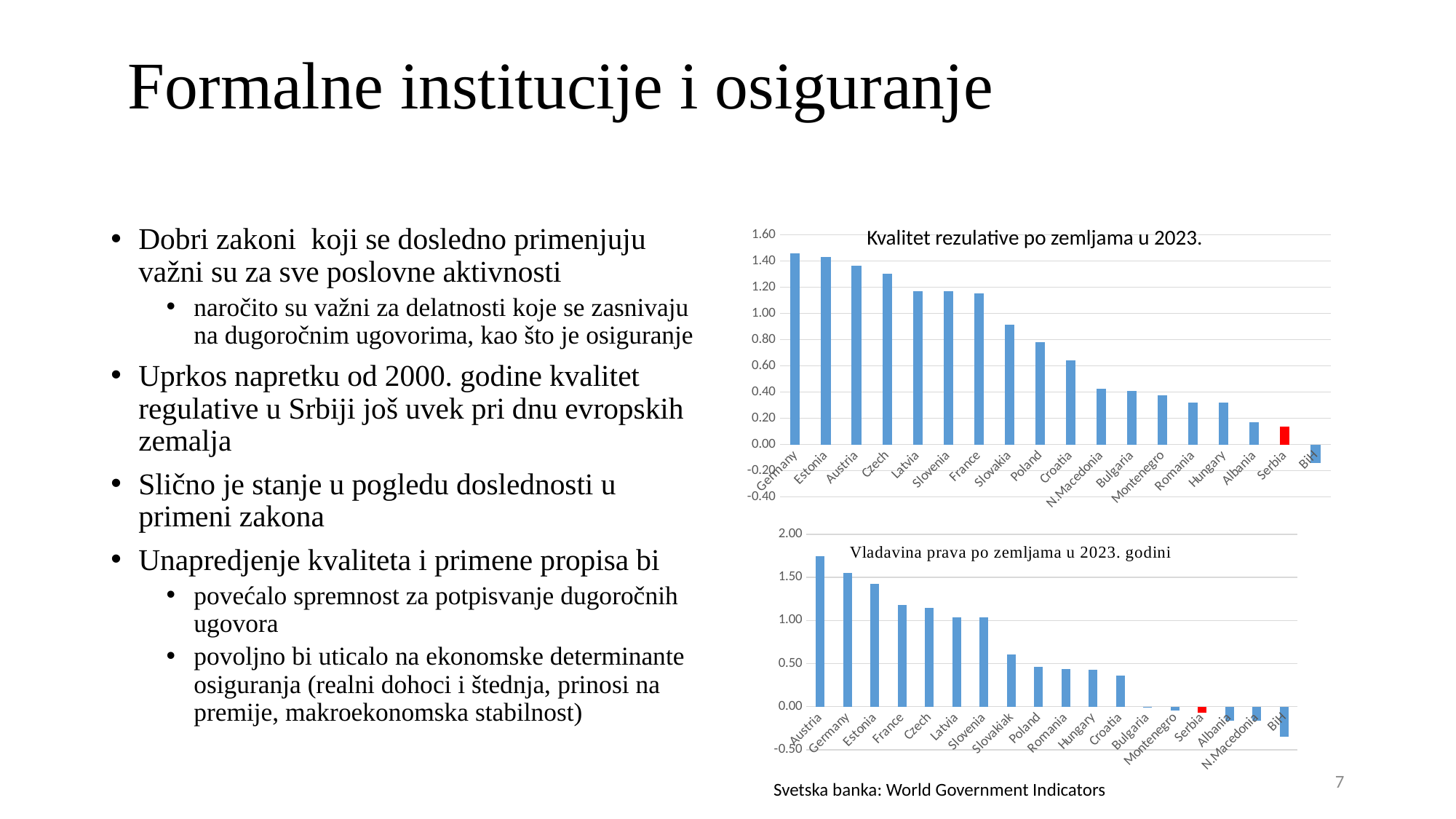
In the top chart, 'Kvalitet rezulative po zemljama u 2023.', which country has the highest value? Germany In the bottom chart, 'Vladavina prava po zemljama u 2023. godini', which country has the lowest value? BiH In the bottom chart, 'Vladavina prava po zemljama u 2023. godini', which has the larger value, Estonia or Croatia? Estonia In the bottom chart, 'Vladavina prava po zemljama u 2023. godini', how many countries are plotted? 18 In the bottom chart, 'Vladavina prava po zemljama u 2023. godini', is the value for Poland greater or less than 1.00? less In the top chart, 'Kvalitet rezulative po zemljama u 2023.', what kind of chart is shown? bar chart In the top chart, 'Kvalitet rezulative po zemljama u 2023.', how many countries are plotted? 18 In the top chart, 'Kvalitet rezulative po zemljama u 2023.', which country's bar is coloured red? Serbia In the top chart, 'Kvalitet rezulative po zemljama u 2023.', which country has the lowest value? BiH In the bottom chart, 'Vladavina prava po zemljama u 2023. godini', which country has the highest value? Austria In the top chart, 'Kvalitet rezulative po zemljama u 2023.', do the values rise or fall from left to right? fall In the top chart, 'Kvalitet rezulative po zemljama u 2023.', is the value for Slovakia greater or less than 0.80? greater